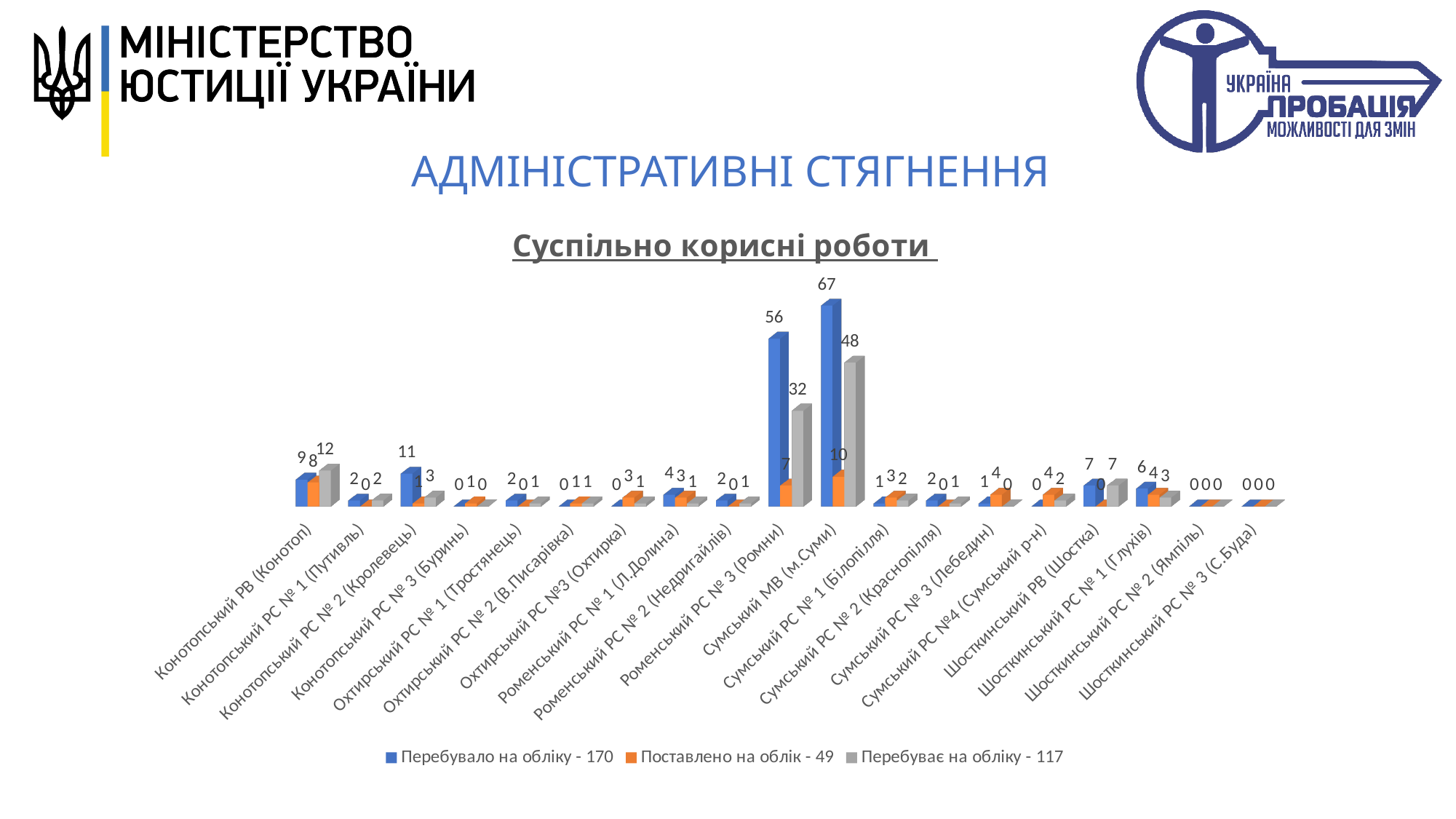
What is the value of "Перебувало на обліку" for Сумський МВ (м.Суми)? 67 What is the difference between the "Перебувало на обліку" values for Сумський МВ (м.Суми) and Роменський РС № 3 (Ромни)? 11 What is the value of "Перебуває на обліку" for Роменський РС № 3 (Ромни)? 32 What is the value of "Перебувало на обліку" for Конотопський РС № 2 (Кролевець)? 11 Which is larger: "Перебуває на обліку" for Сумський МВ (м.Суми) or for Роменський РС № 3 (Ромни)? Сумський МВ (м.Суми) How many categories are shown on the x axis of the chart? 19 What is the title of the chart? Суспільно корисні роботи What type of chart is shown on the slide? bar chart Which category has the highest value for "Перебувало на обліку"? Сумський МВ (м.Суми) What is the value of "Поставлено на облік" for Конотопський РВ (Конотоп)? 8 How many series does the legend list? 3 What is the value of "Поставлено на облік" for Сумський МВ (м.Суми)? 10